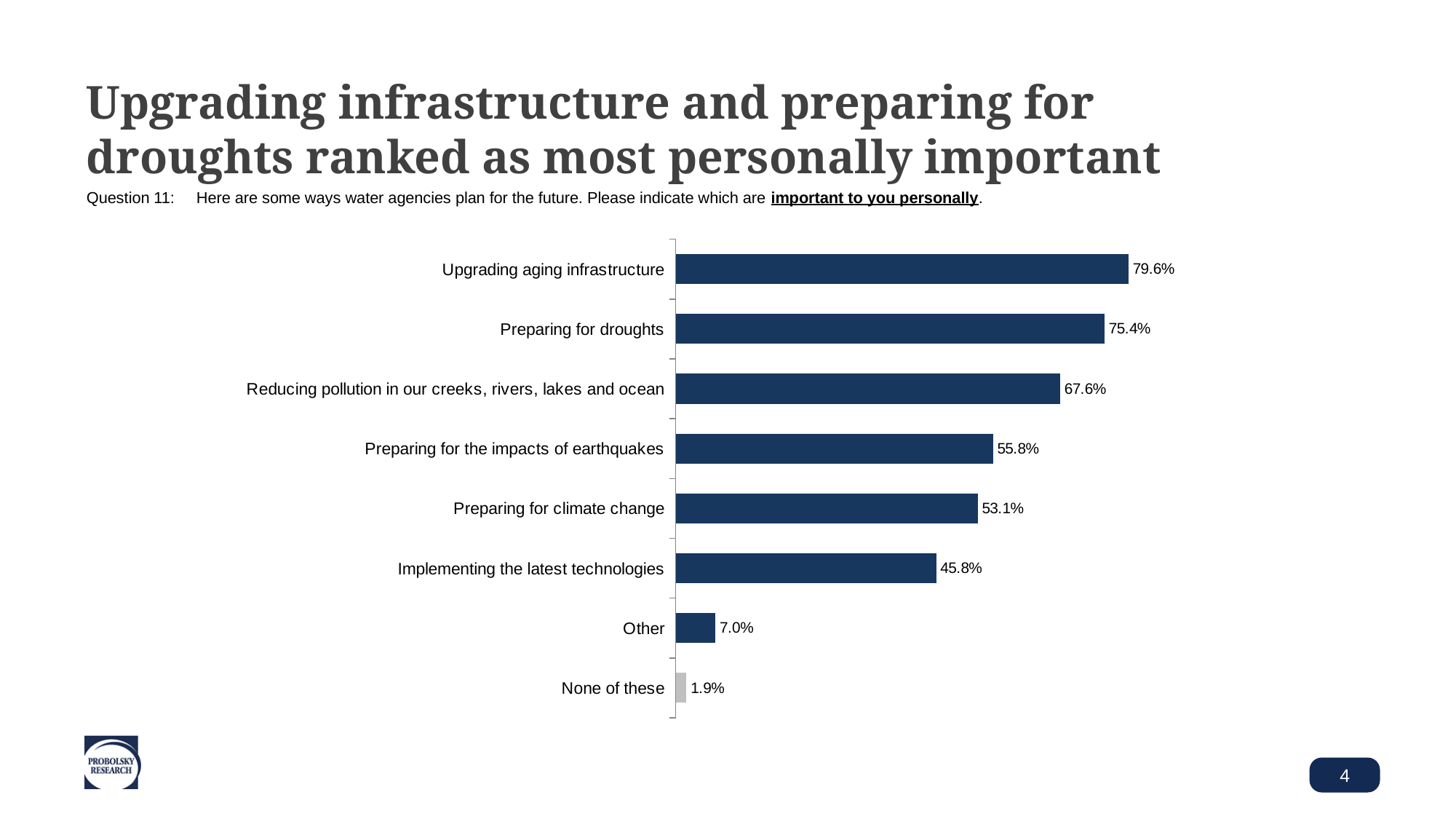
Which category has the lowest value? None of these What kind of chart is shown on the slide? Bar chart What is the difference between the values for Upgrading aging infrastructure and Preparing for droughts? 4.2% Which is larger: the value for Preparing for the impacts of earthquakes or Preparing for climate change? Preparing for the impacts of earthquakes What is the value shown for Preparing for droughts? 75.4% Which bar is shown in a different colour (grey) from the others? None of these Which category has the highest value? Upgrading aging infrastructure What percentage of respondents said upgrading aging infrastructure is important to them personally? 79.6% What is the difference between the values for Other and None of these? 5.1% How many categories are shown in the chart? 8 What percentage is shown for Implementing the latest technologies? 45.8% What is the value for None of these? 1.9%